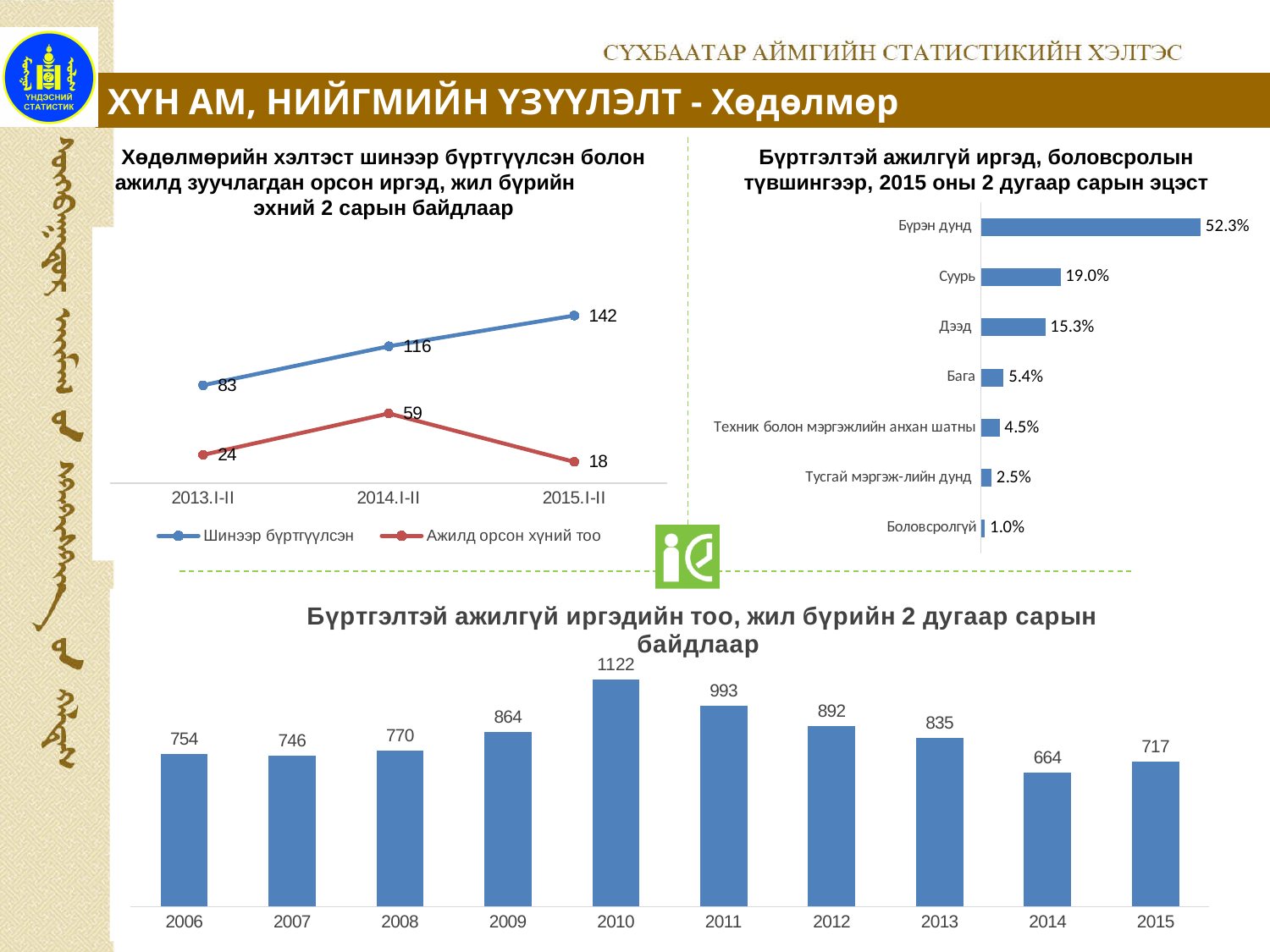
In the top-right chart (Бүртгэлтэй ажилгүй иргэд, боловсролын түвшингээр), which category has the lowest value? Боловсролгүй In the top-left line chart, what is the value for Ажилд орсон хүний тоо in 2014.I-II? 59 In the top-right chart (Бүртгэлтэй ажилгүй иргэд, боловсролын түвшингээр), how many categories are shown? 7 In the top-right chart (Бүртгэлтэй ажилгүй иргэд, боловсролын түвшингээр), what is the value for Дээд? 15.3% In the bottom chart (Бүртгэлтэй ажилгүй иргэдийн тоо), what is the value for 2010? 1122 In the top-left line chart, what is the value for Шинээр бүртгүүлсэн in 2015.I-II? 142 In the bottom chart (Бүртгэлтэй ажилгүй иргэдийн тоо), which year has the lowest value? 2014 In the top-left line chart, what is the difference between Шинээр бүртгүүлсэн and Ажилд орсон хүний тоо in 2013.I-II? 59 In the top-left line chart, does the Шинээр бүртгүүлсэн series rise or fall from 2013.I-II to 2015.I-II? rise In the bottom chart (Бүртгэлтэй ажилгүй иргэдийн тоо), what is the difference between the values for 2011 and 2012? 101 In the top-right chart (Бүртгэлтэй ажилгүй иргэд, боловсролын түвшингээр), which category has the highest value? Бүрэн дунд In the top-left line chart, how many series does the legend list? 2